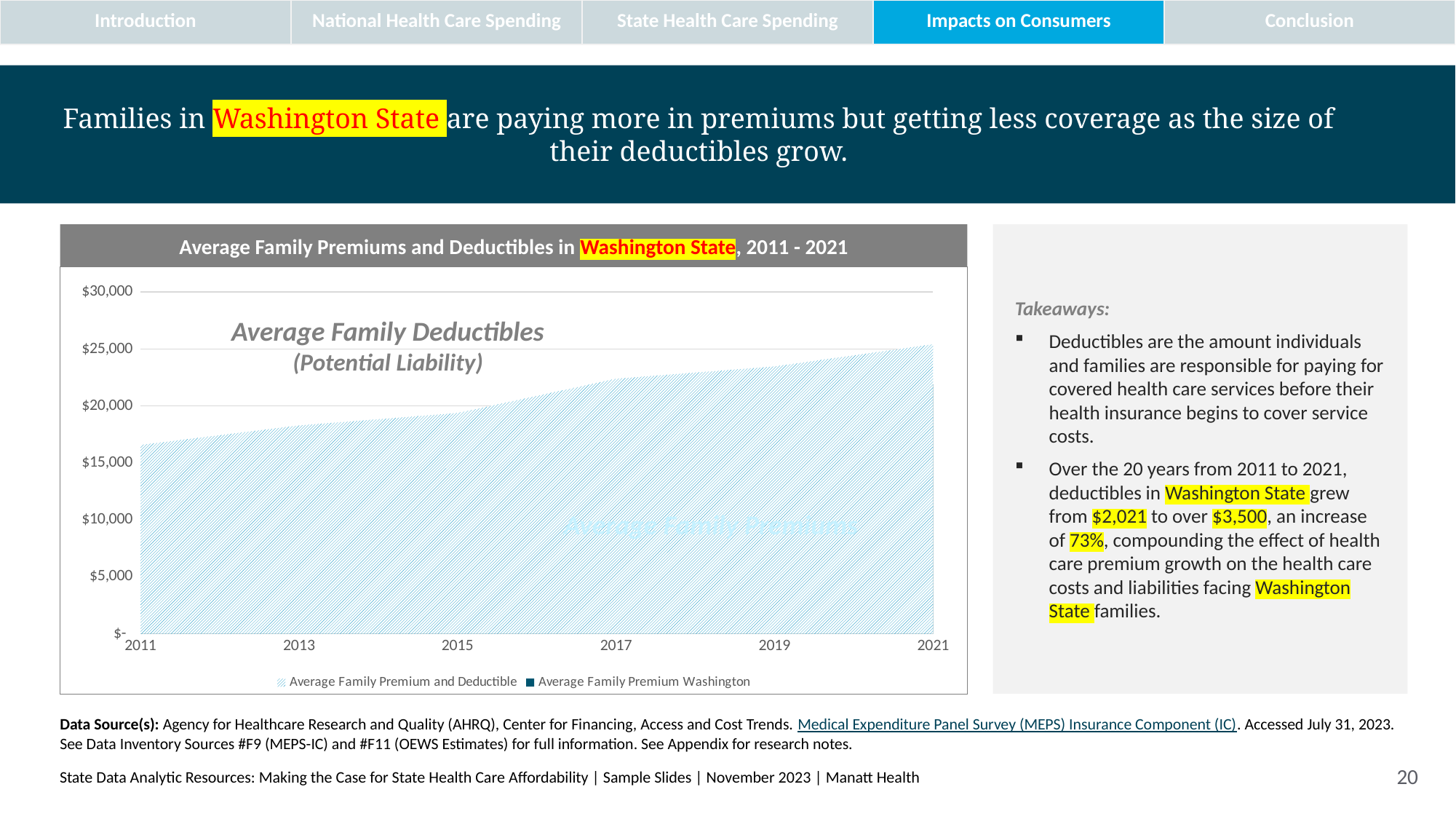
Is the Average Family Premium and Deductible value for 2011 greater or less than $15,000? greater What are the two series named in the chart legend? Average Family Premium and Deductible; Average Family Premium Washington What kind of chart is shown on the slide? Area chart Is the Average Family Premium and Deductible value for 2017 greater or less than $20,000? greater Is the Average Family Premium and Deductible value for 2011 greater or less than $20,000? less Does the Average Family Premium and Deductible value rise or fall from 2011 to 2021? Rise In which year is the Average Family Premium and Deductible value lowest? 2011 Which year has the larger Average Family Premium and Deductible value, 2013 or 2019? 2019 What is the title of the chart? Average Family Premiums and Deductibles in Washington State, 2011 - 2021 In which year is the Average Family Premium and Deductible value highest? 2021 How many series does the chart legend list? 2